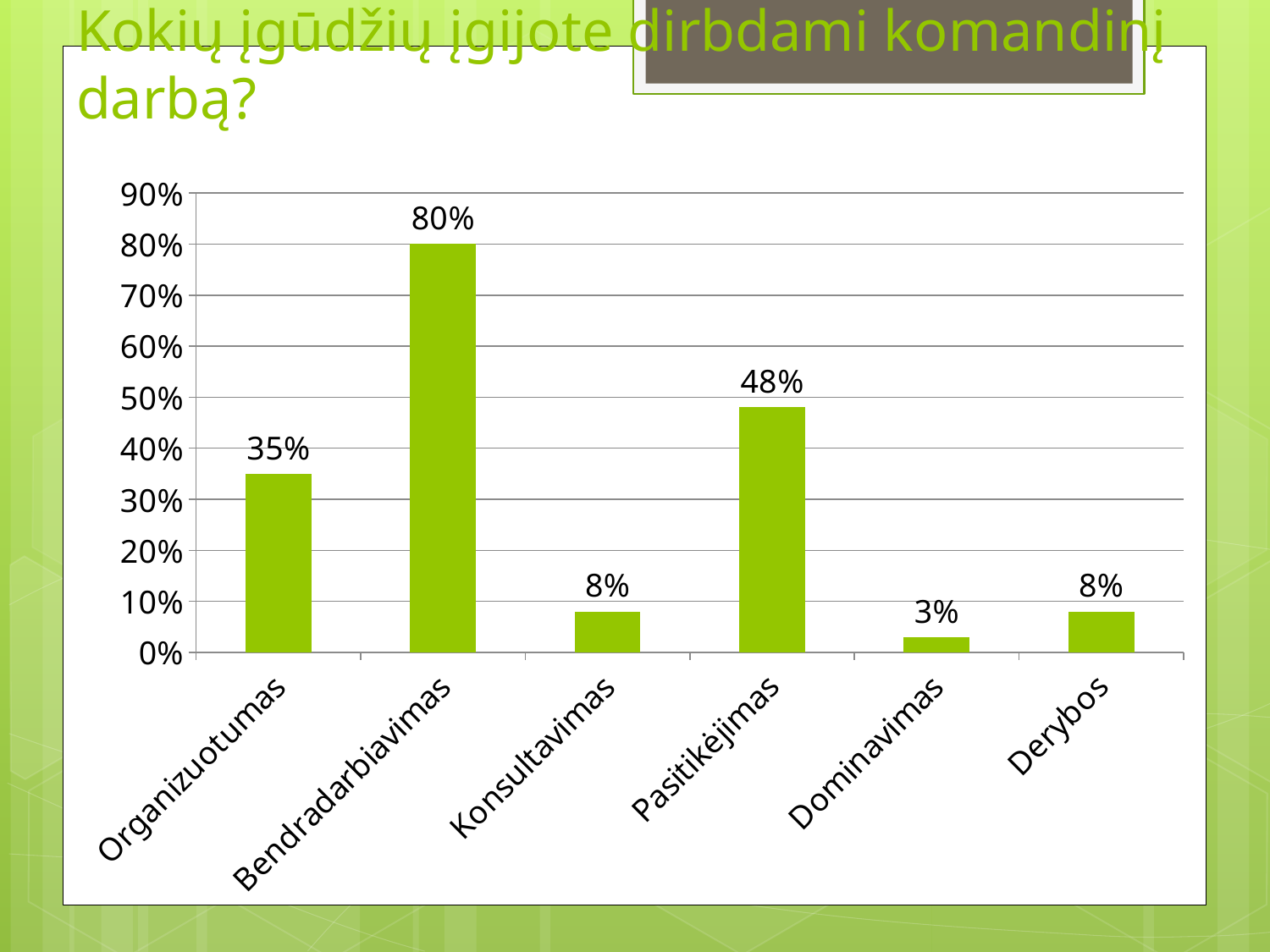
Is the value for Pasitikėjimas greater or less than 40%? greater Which category has the lowest value? Dominavimas What is the value for Bendradarbiavimas? 80% What is the difference between the values for Bendradarbiavimas and Pasitikėjimas? 32% How many categories are shown on the x axis? 6 Which is larger, the value for Organizuotumas or the value for Pasitikėjimas? Pasitikėjimas Which category has the highest value? Bendradarbiavimas What is the value for Organizuotumas? 35% What is the value for Dominavimas? 3% What kind of chart is shown on the slide? bar chart What is the value for Pasitikėjimas? 48% What is the highest value shown on the y axis? 90%